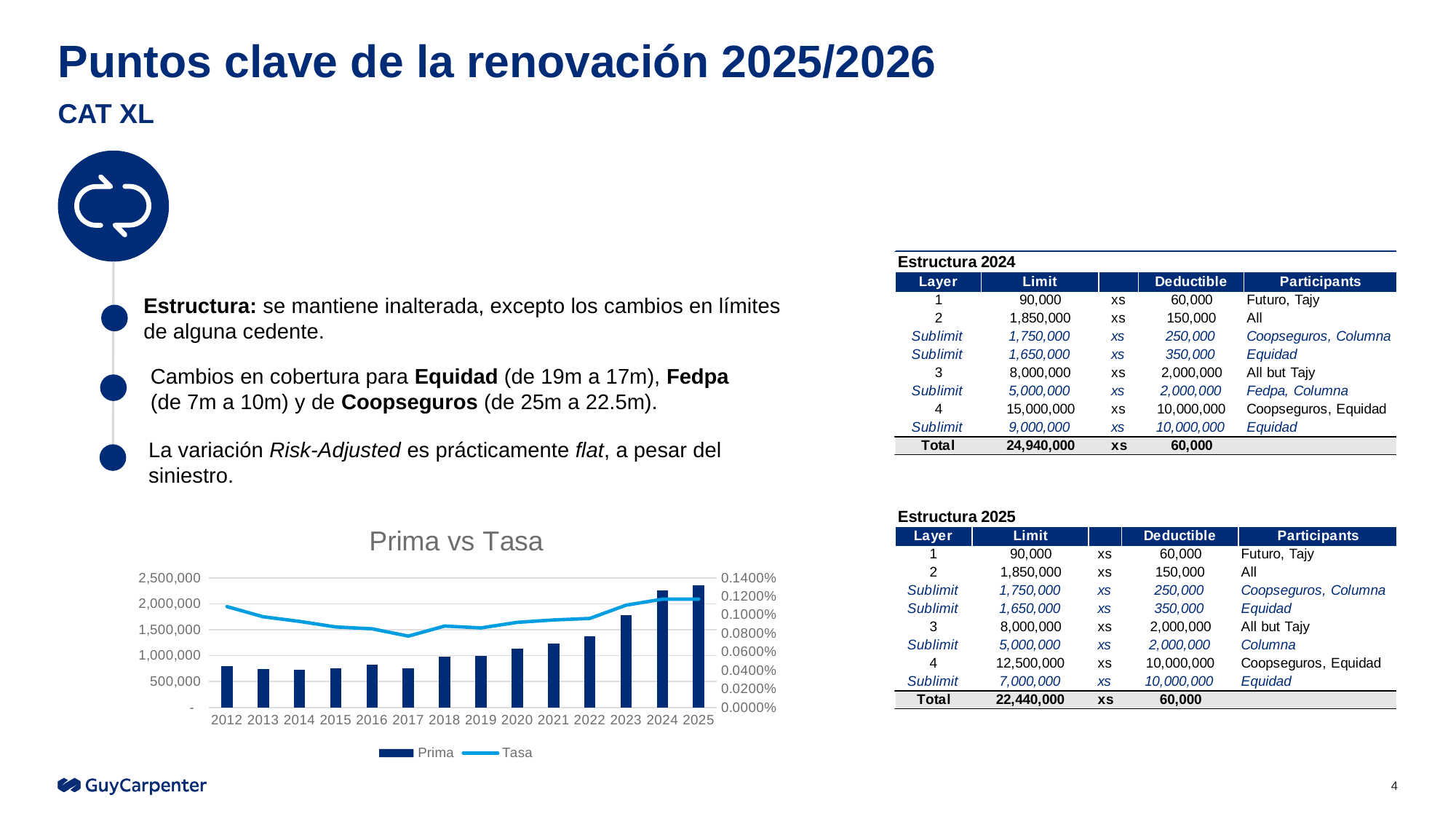
In the 'Prima vs Tasa' chart, which is larger, the Prima value for 2024 or for 2012? 2024 In the 'Prima vs Tasa' chart, is the Tasa value for 2012 greater or less than 0.1000%? greater Which series in the 'Prima vs Tasa' chart is drawn as a line? Tasa What kind of chart is 'Prima vs Tasa'? Combined bar and line chart In the 'Prima vs Tasa' chart, is the Prima value for 2012 greater or less than 1,000,000? less How many years are shown on the x axis of the 'Prima vs Tasa' chart? 14 In the 'Prima vs Tasa' chart, is the Prima value for 2024 greater or less than 2,000,000? greater In the 'Prima vs Tasa' chart, which year has the lowest Tasa value? 2017 What is the title of the chart on the slide? Prima vs Tasa How many series does the legend of the 'Prima vs Tasa' chart list? 2 In the 'Prima vs Tasa' chart, do the Prima bars generally rise or fall from 2012 to 2025? rise